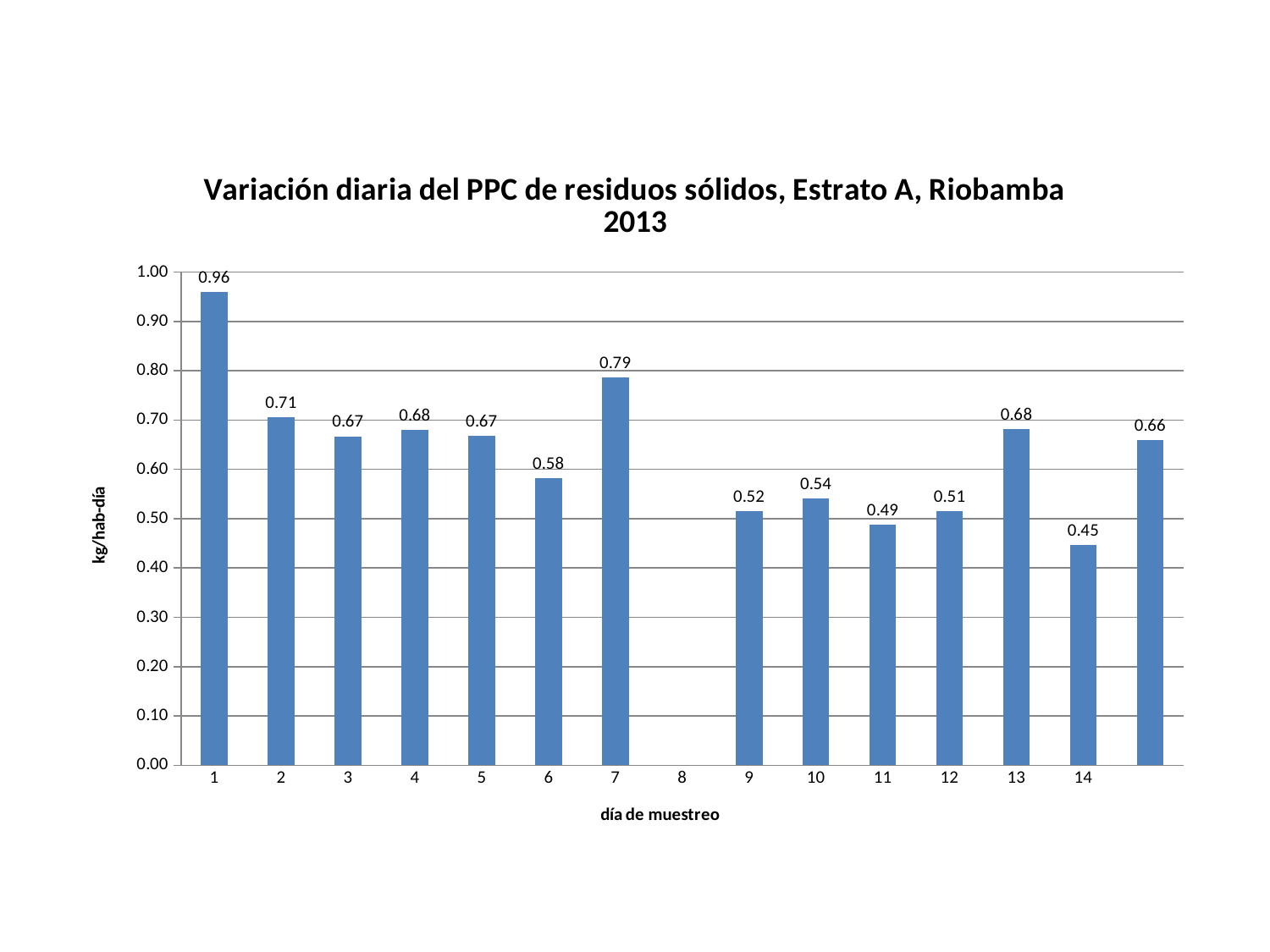
Is the value for day 6 greater or less than 0.60? less Which sampling day has the lowest plotted value? 14 What kind of chart is shown on the slide? bar chart Which is larger, the value for day 2 or the value for day 13? day 2 What is the value for day 14? 0.45 What is the label of the vertical axis? kg/hab-día What is the difference between the values for day 13 and day 14? 0.23 Which sampling day has the highest value? 1 What is the value for day 7? 0.79 What is the difference between the values for day 1 and day 7? 0.17 What is the value for day 11? 0.49 What is the value for day 1 (día de muestreo 1)? 0.96